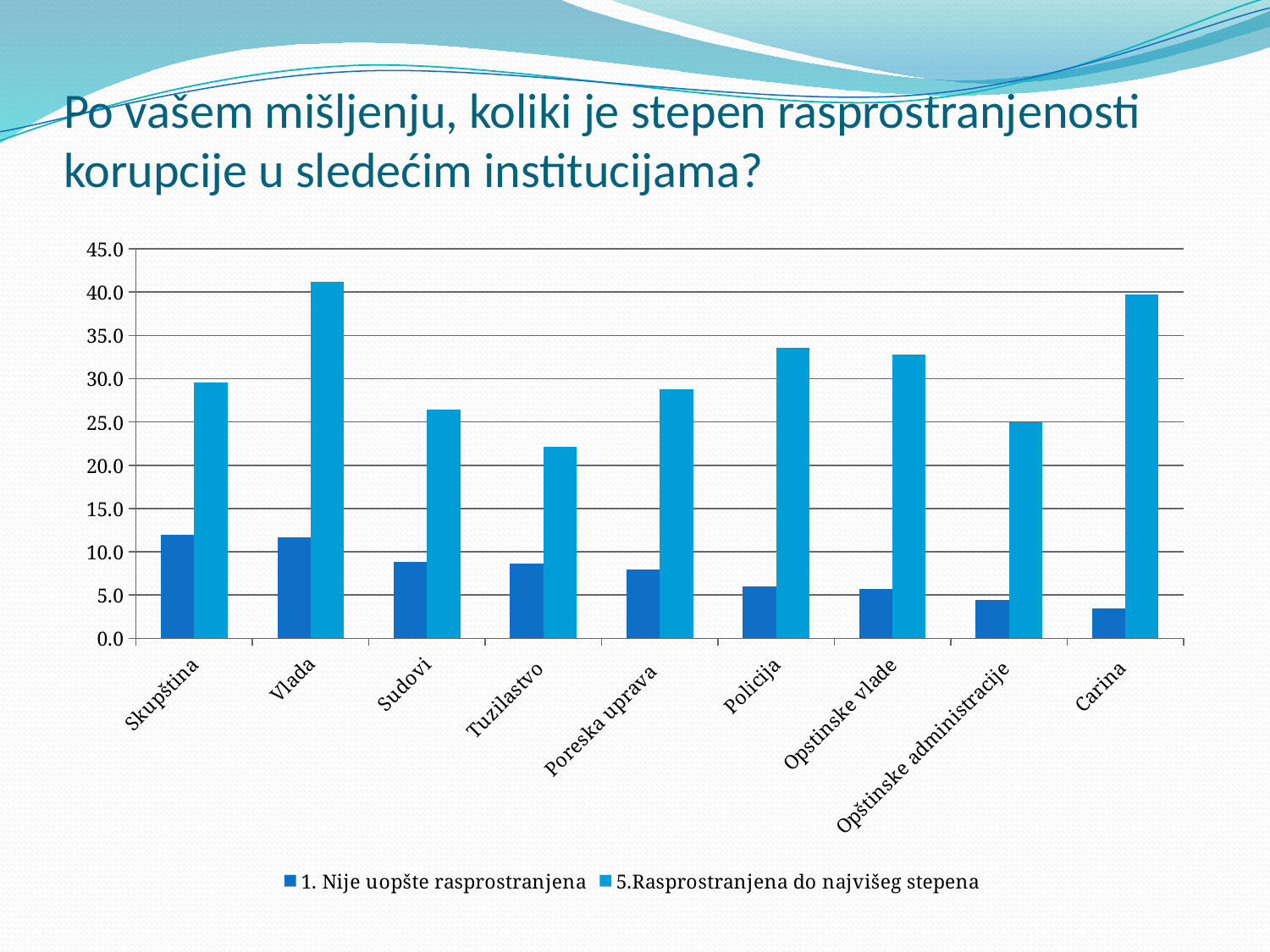
Is the value for Vlada in the series '5.Rasprostranjena do najvišeg stepena' greater or less than 40.0? greater Is the value for Policija in the series '5.Rasprostranjena do najvišeg stepena' greater or less than 30.0? greater How many institutions (categories) are shown on the x axis? 9 What kind of chart is shown on the slide? bar chart Do the values of the series '1. Nije uopšte rasprostranjena' rise or fall from Skupština to Carina along the x axis? fall Is the value for Carina in the series '1. Nije uopšte rasprostranjena' greater or less than 5.0? less Which legend entry is shown in the darker blue colour? 1. Nije uopšte rasprostranjena How many series does the legend list? 2 For the series '5.Rasprostranjena do najvišeg stepena', which is larger: Policija or Sudovi? Policija Which institution has the highest value for the series '5.Rasprostranjena do najvišeg stepena'? Vlada Which institution has the lowest value for the series '5.Rasprostranjena do najvišeg stepena'? Tuzilastvo